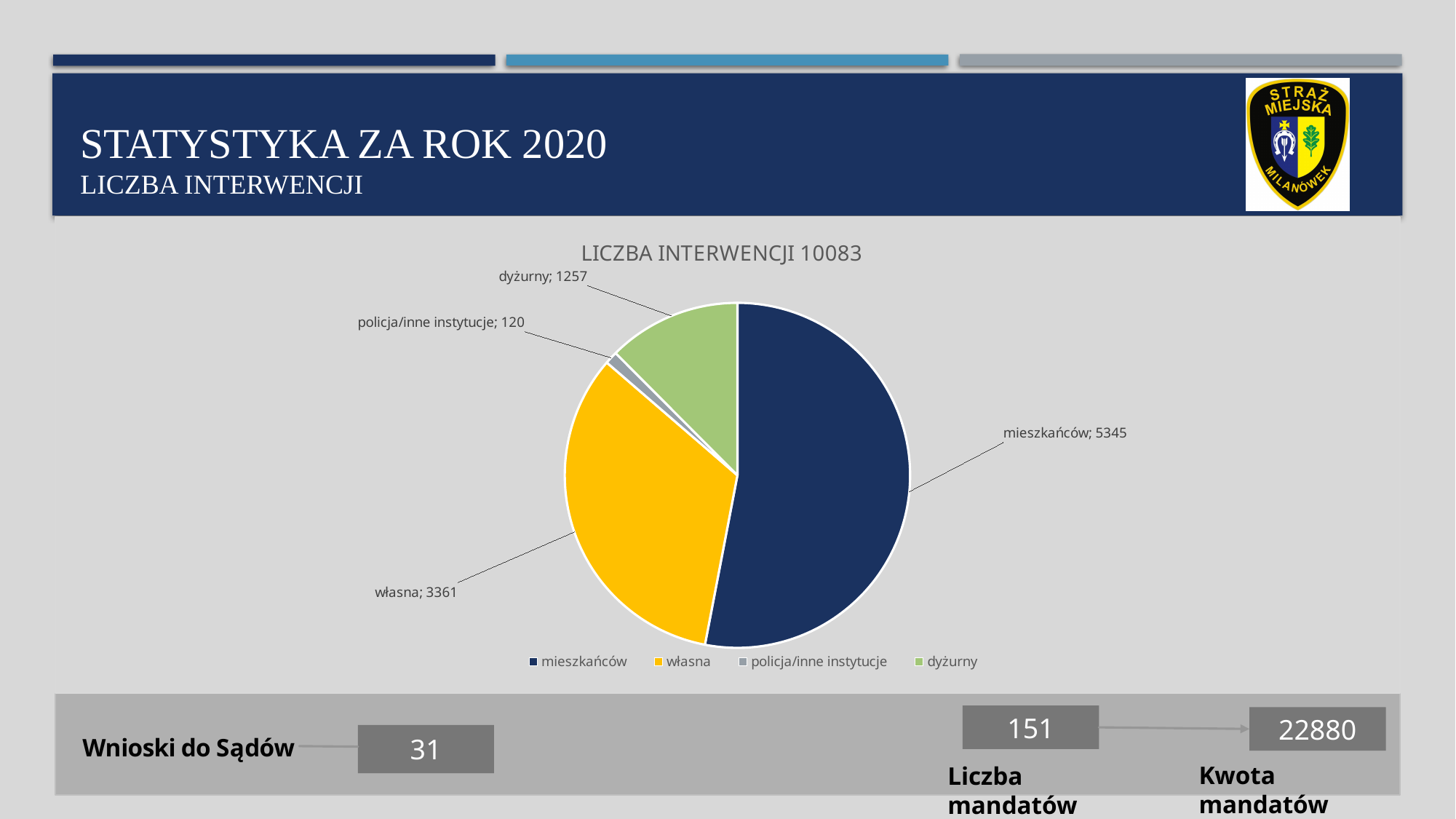
What is the value for mieszkańców? 5345 What type of chart is shown on the slide? pie chart Which category has the largest slice? mieszkańców What is the value for policja/inne instytucje? 120 What colour is the własna slice? yellow What is the title of the chart? LICZBA INTERWENCJI 10083 Which category has the smallest slice? policja/inne instytucje How many slices does the pie chart have? 4 What is the value for własna? 3361 What is the difference between the values for mieszkańców and własna? 1984 What is the value for dyżurny? 1257 Which is larger, dyżurny or własna? własna